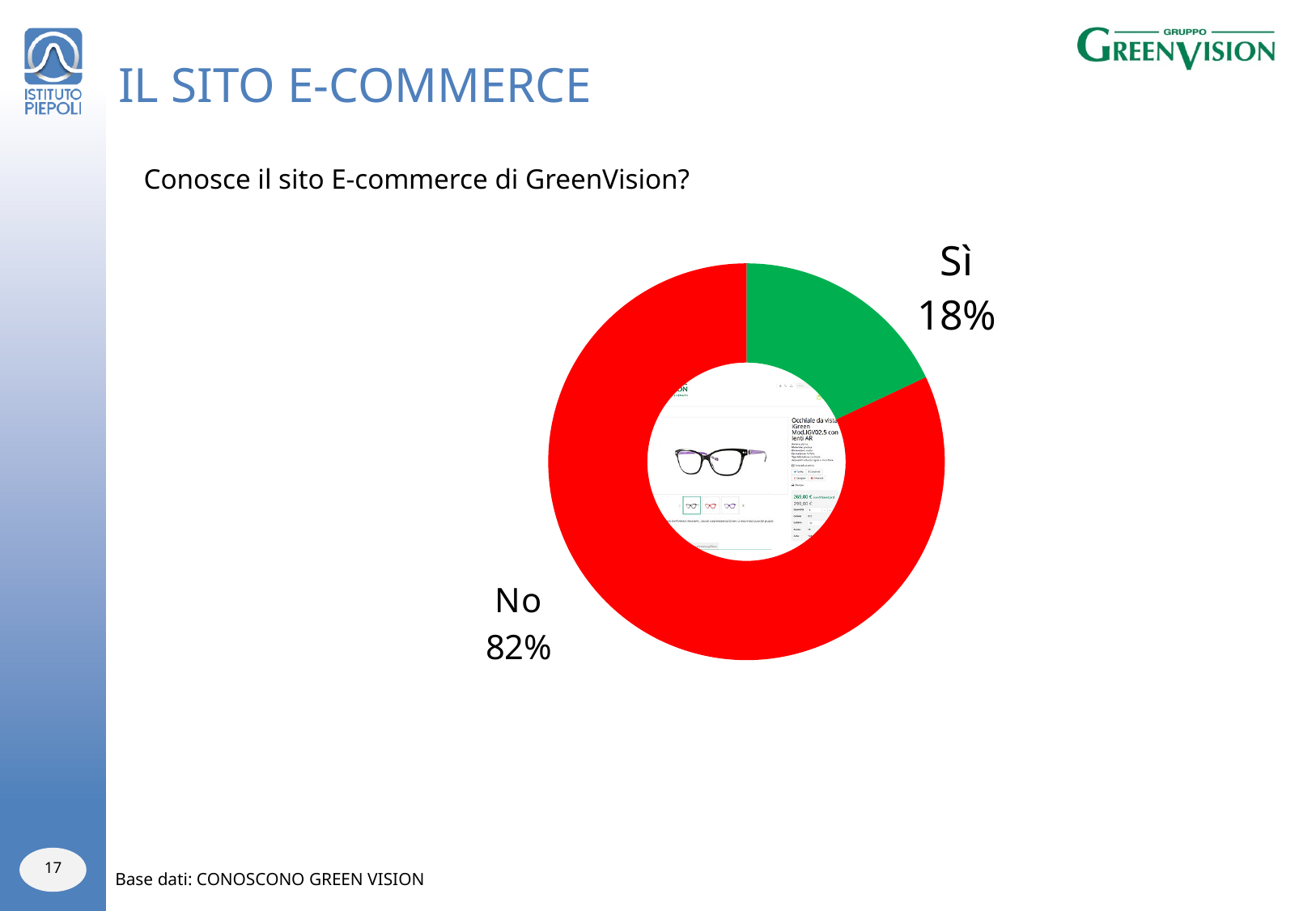
What question does the chart answer, as written above it? Conosce il sito E-commerce di GreenVision? Which response has the largest share of the chart? No Which is larger, the share for "Sì" or the share for "No"? No What kind of chart is shown on the slide? Pie chart (doughnut) Which response has the smallest share of the chart? Sì What share of the pie does the "Sì" slice represent? 18% What percentage of respondents answered "No"? 82% What percentage of respondents answered "Sì"? 18% What is the difference in percentage points between the "No" and "Sì" shares? 64 How many categories are shown in the chart? 2 What colour is the "No" slice of the chart? Red